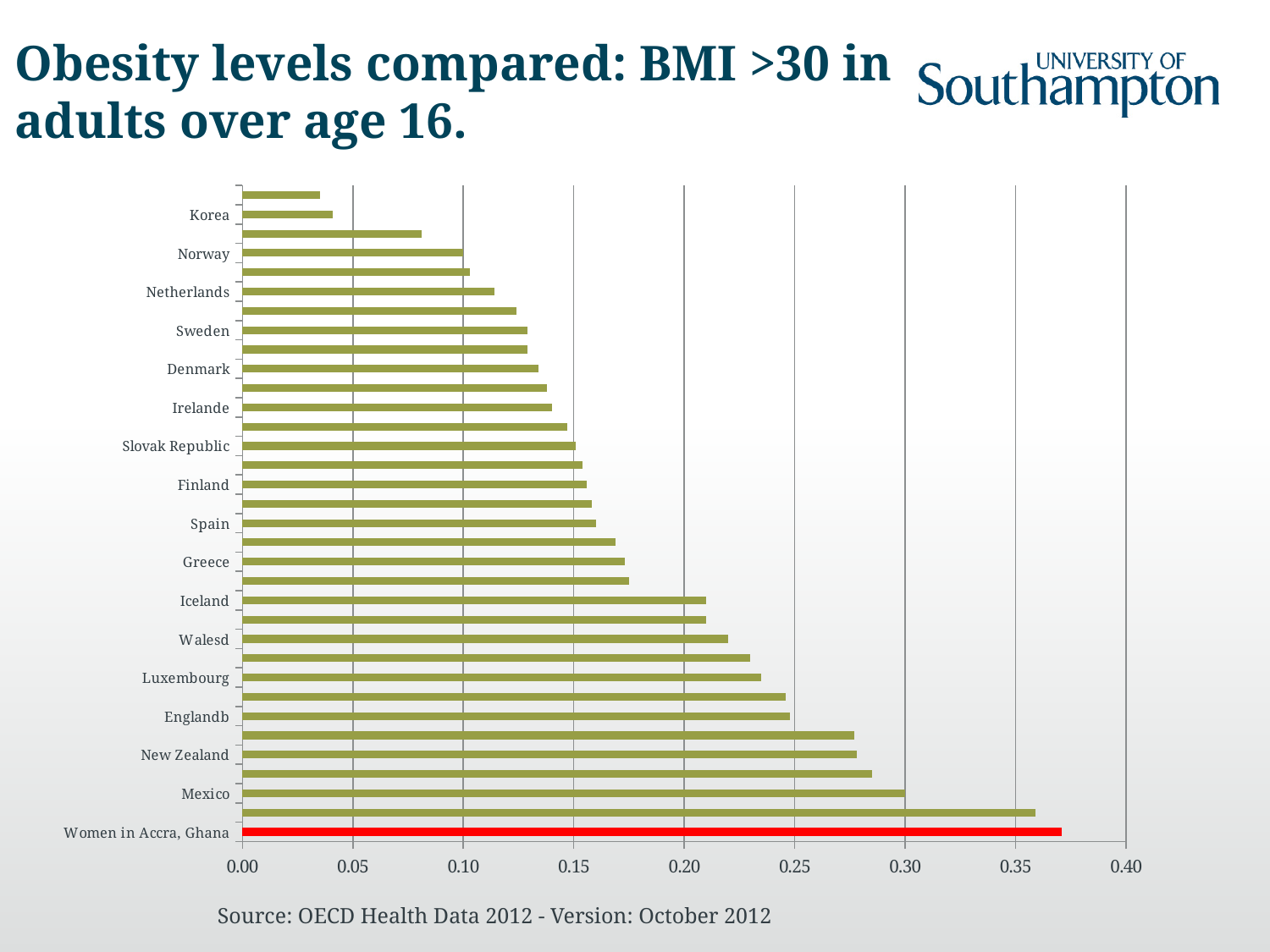
Is the value for Greece greater or less than 0.20? less What is the value for Mexico? 0.30 What kind of chart is shown on the slide? bar chart Which has a higher value, Mexico or New Zealand? Mexico Which category has the highest obesity level in the chart? Women in Accra, Ghana Is the value for Women in Accra, Ghana greater or less than 0.35? greater Do the bars get longer or shorter going from the top of the chart to the bottom? longer What colour is the bar for Women in Accra, Ghana? red Is the value for New Zealand greater or less than 0.25? greater Which has a higher value, Korea or Norway? Norway